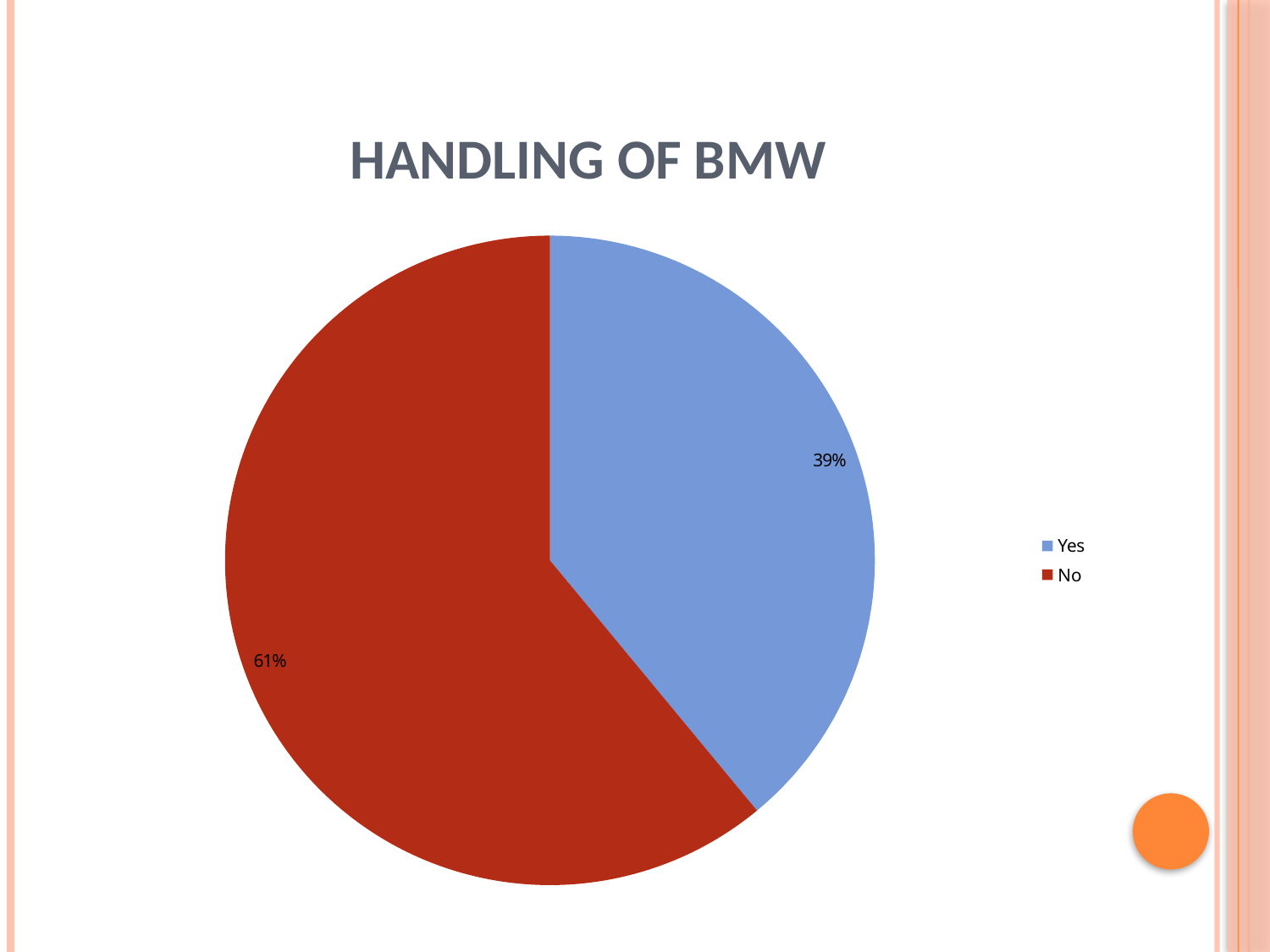
Which slice is the smallest? Yes How many slices does the pie chart have? 2 What kind of chart is shown on the slide? pie chart What percentage of the pie is labelled "Yes"? 39% Which is larger, the "Yes" slice or the "No" slice? No How many entries does the legend list? 2 What is the title of the chart? HANDLING OF BMW What colour is the "No" slice? red Which slice is the largest? No What is the difference in percentage points between the "No" and "Yes" slices? 22 What share of the pie does the "Yes" slice represent? 39% What percentage of the pie is labelled "No"? 61%